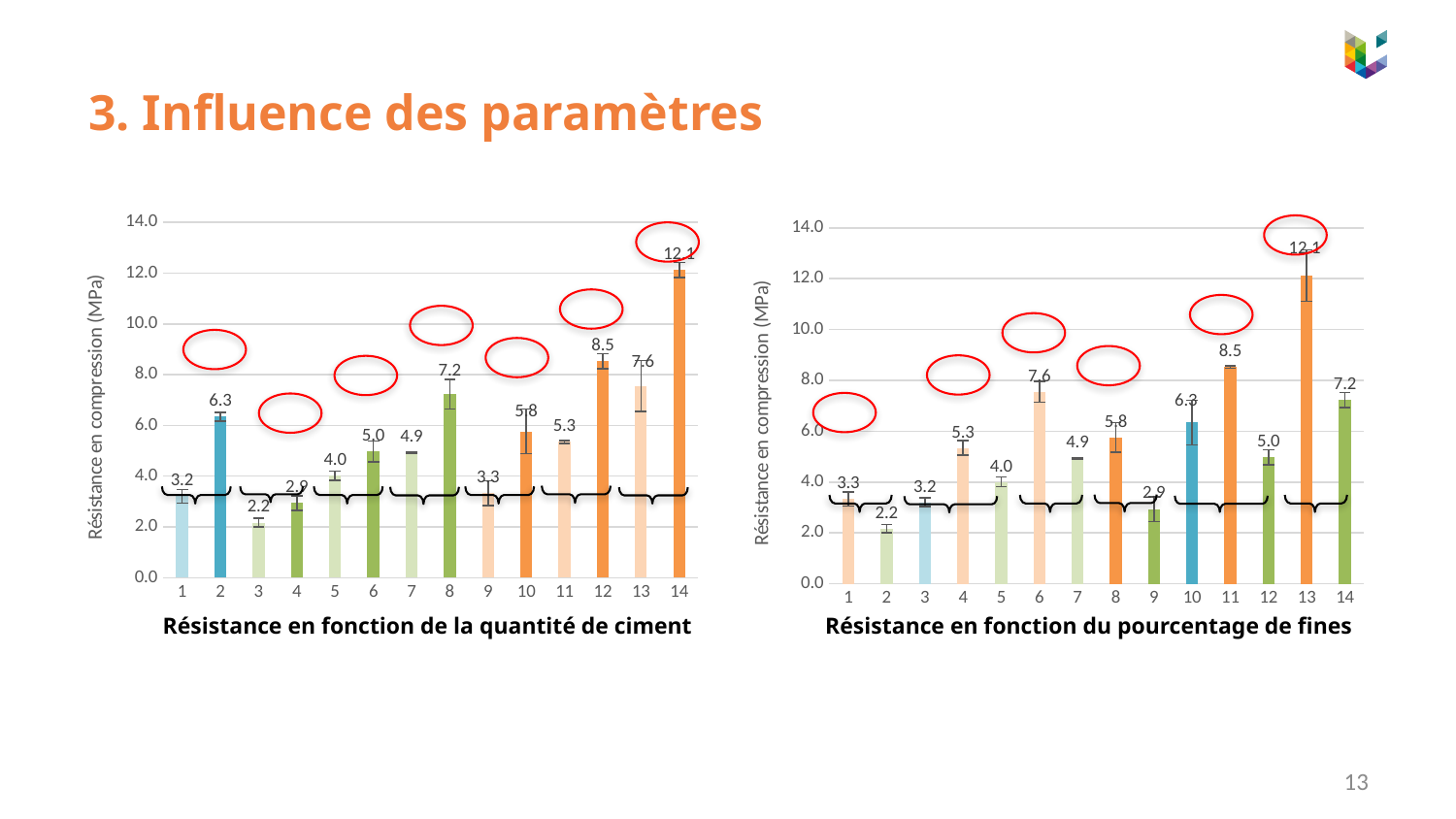
In the chart 'Résistance en fonction du pourcentage de fines', which is larger, the value for category 4 or the value for category 5? Category 4 In the chart 'Résistance en fonction du pourcentage de fines', which category has the highest value? 13 In the chart 'Résistance en fonction de la quantité de ciment', what is the difference between the values for category 14 and category 12? 3.6 What is the y-axis label of the chart 'Résistance en fonction du pourcentage de fines'? Résistance en compression (MPa) In the chart 'Résistance en fonction du pourcentage de fines', what is the value for category 11? 8.5 In the chart 'Résistance en fonction de la quantité de ciment', is the value for category 8 greater or less than 6.0? greater In the chart 'Résistance en fonction du pourcentage de fines', what is the value for category 6? 7.6 In the chart 'Résistance en fonction de la quantité de ciment', what is the value for category 2? 6.3 In the chart 'Résistance en fonction de la quantité de ciment', what is the value for category 14? 12.1 How many categories are shown on the x axis of the chart 'Résistance en fonction du pourcentage de fines'? 14 What type of chart is 'Résistance en fonction de la quantité de ciment'? Bar chart In the chart 'Résistance en fonction de la quantité de ciment', which category has the lowest value? 3